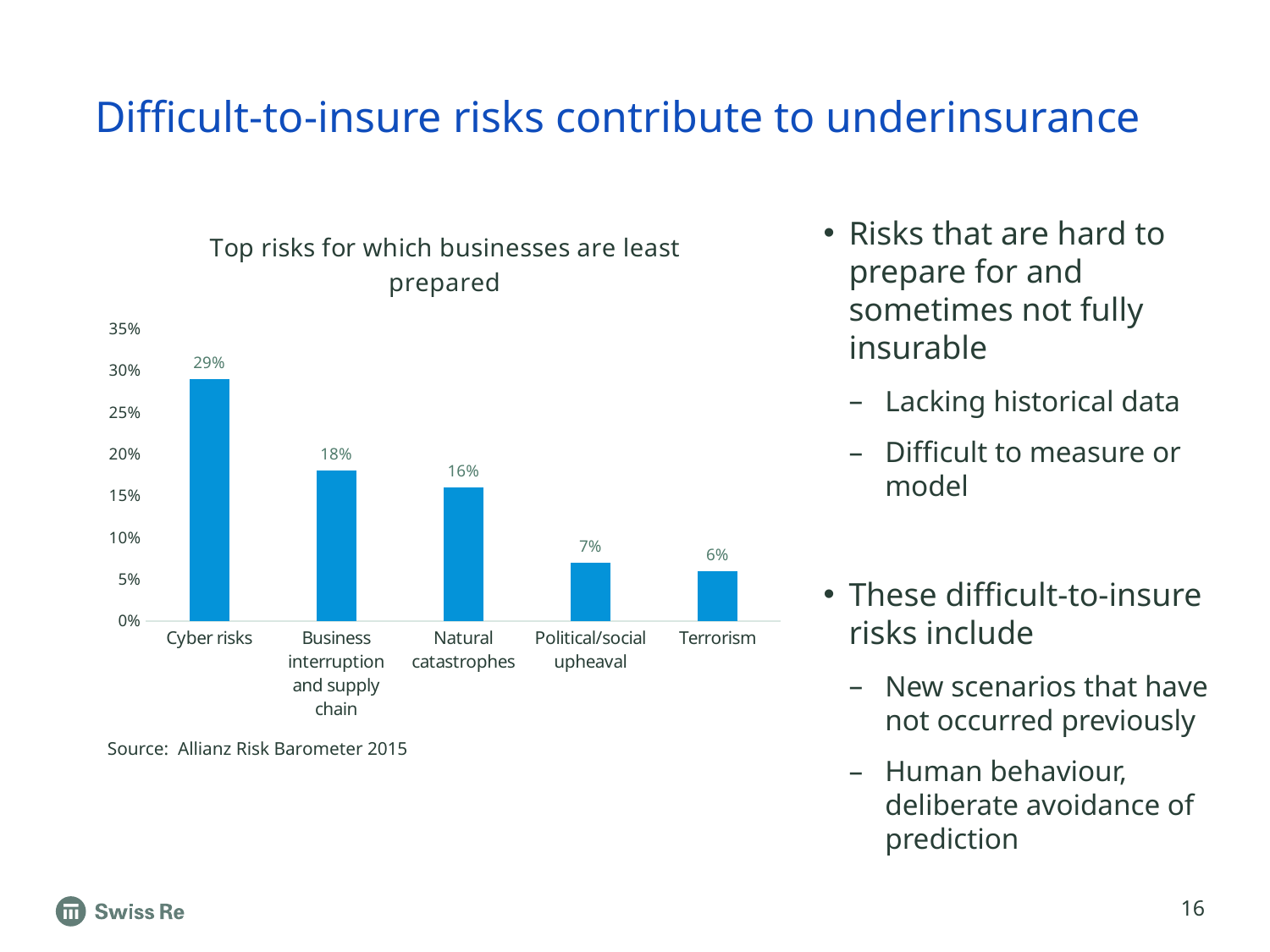
What is the title of the chart? Top risks for which businesses are least prepared Which category has the highest value? Cyber risks What kind of chart is shown on the slide? Bar chart What is the value for Natural catastrophes? 16% What is the value for Cyber risks? 29% What is the value for Terrorism? 6% How many categories are shown in the chart? 5 Which category has the lowest value? Terrorism Which is larger, the value for Political/social upheaval or the value for Terrorism? Political/social upheaval What is the difference between the values for Cyber risks and Natural catastrophes? 13% Is the value for Business interruption and supply chain greater or less than 20%? less What is the value for Business interruption and supply chain? 18%